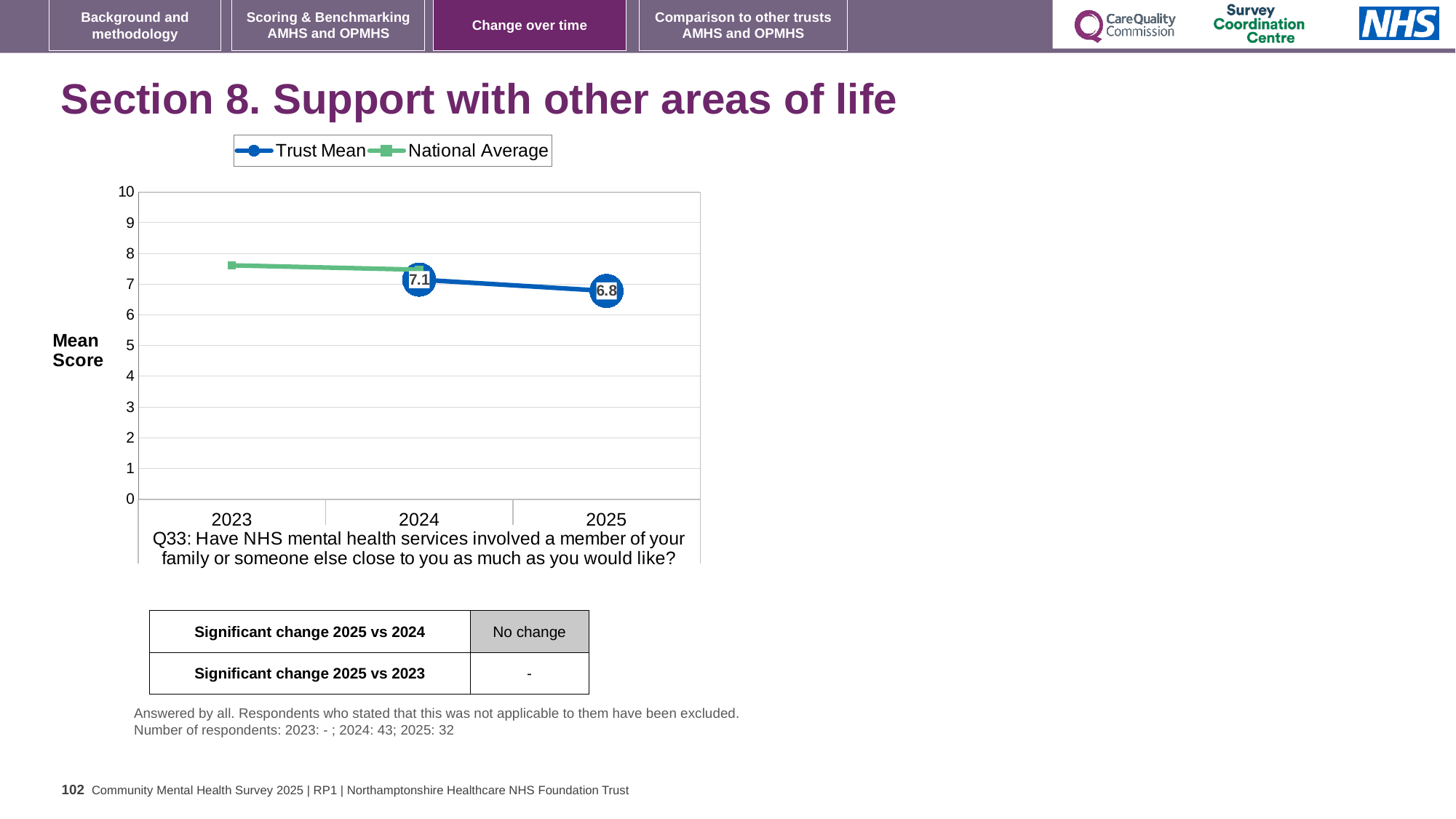
Is the National Average value for 2023 greater or less than 7? greater What kind of chart is shown on the slide? line chart What is the label on the y axis of the chart? Mean Score By how much did the Trust Mean fall from 2024 to 2025? 0.3 How many years are shown on the x axis? 3 In which year is the Trust Mean highest? 2024 Does the Trust Mean rise or fall from 2024 to 2025? fall Is the Trust Mean value for 2025 greater or less than 6? greater What is the Trust Mean value for 2024? 7.1 How many series does the legend list? 2 What is the Trust Mean value for 2025? 6.8